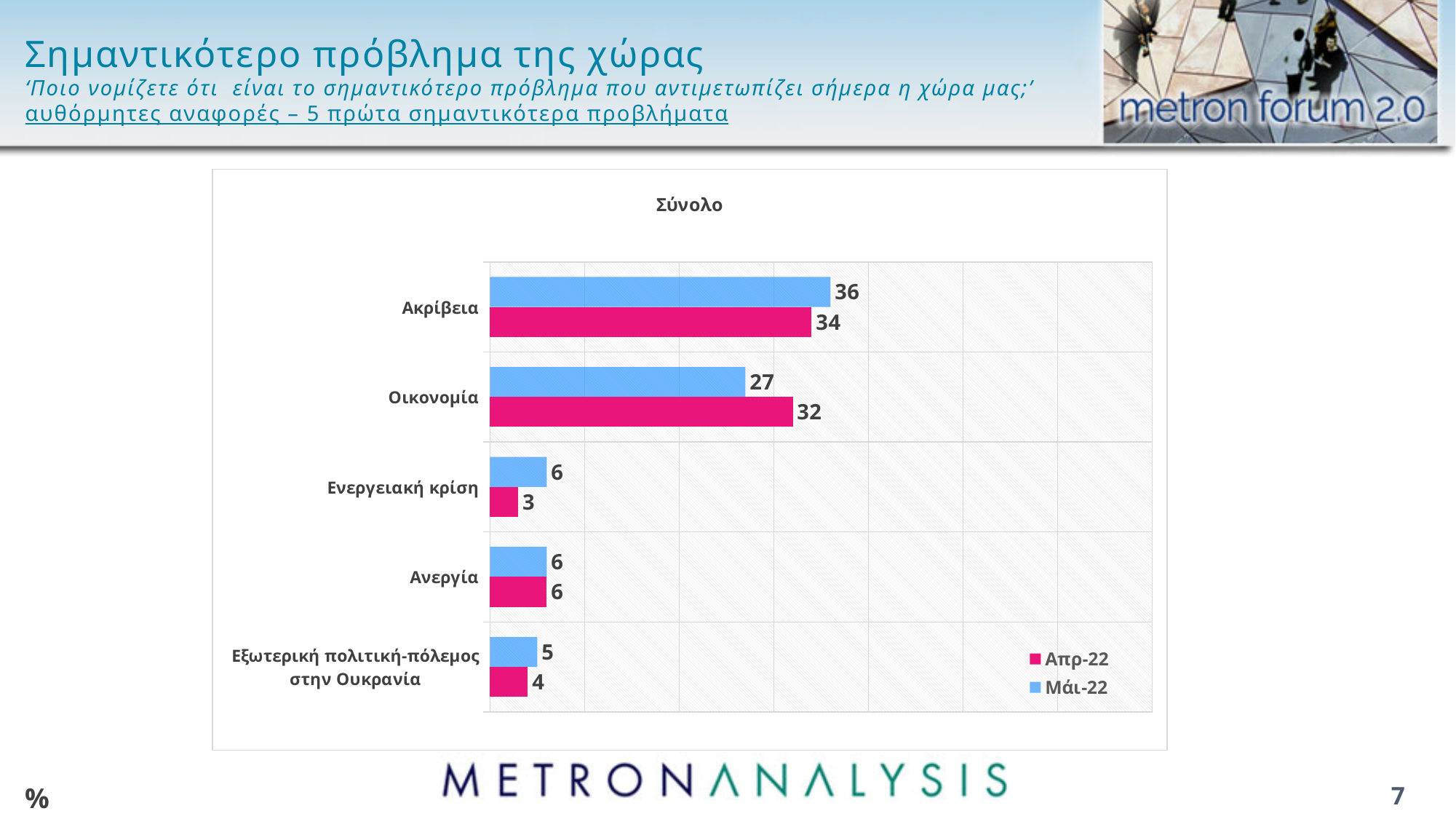
Which colour represents the Απρ-22 series? Pink What is the value for Ενεργειακή κρίση in the Απρ-22 series? 3 What is the title of the chart? Σύνολο What kind of chart is shown on the slide? Bar chart Which category has the highest value in the Μάι-22 series? Ακρίβεια What is the value for Οικονομία in the Απρ-22 series? 32 What is the value for Ακρίβεια in the Μάι-22 series? 36 How many categories are shown on the chart? 5 Which is larger for Ακρίβεια: the Απρ-22 value or the Μάι-22 value? Μάι-22 How many series does the legend list? 2 What is the difference between the Απρ-22 and Μάι-22 values for Οικονομία? 5 Which category has the lowest value in the Απρ-22 series? Ενεργειακή κρίση